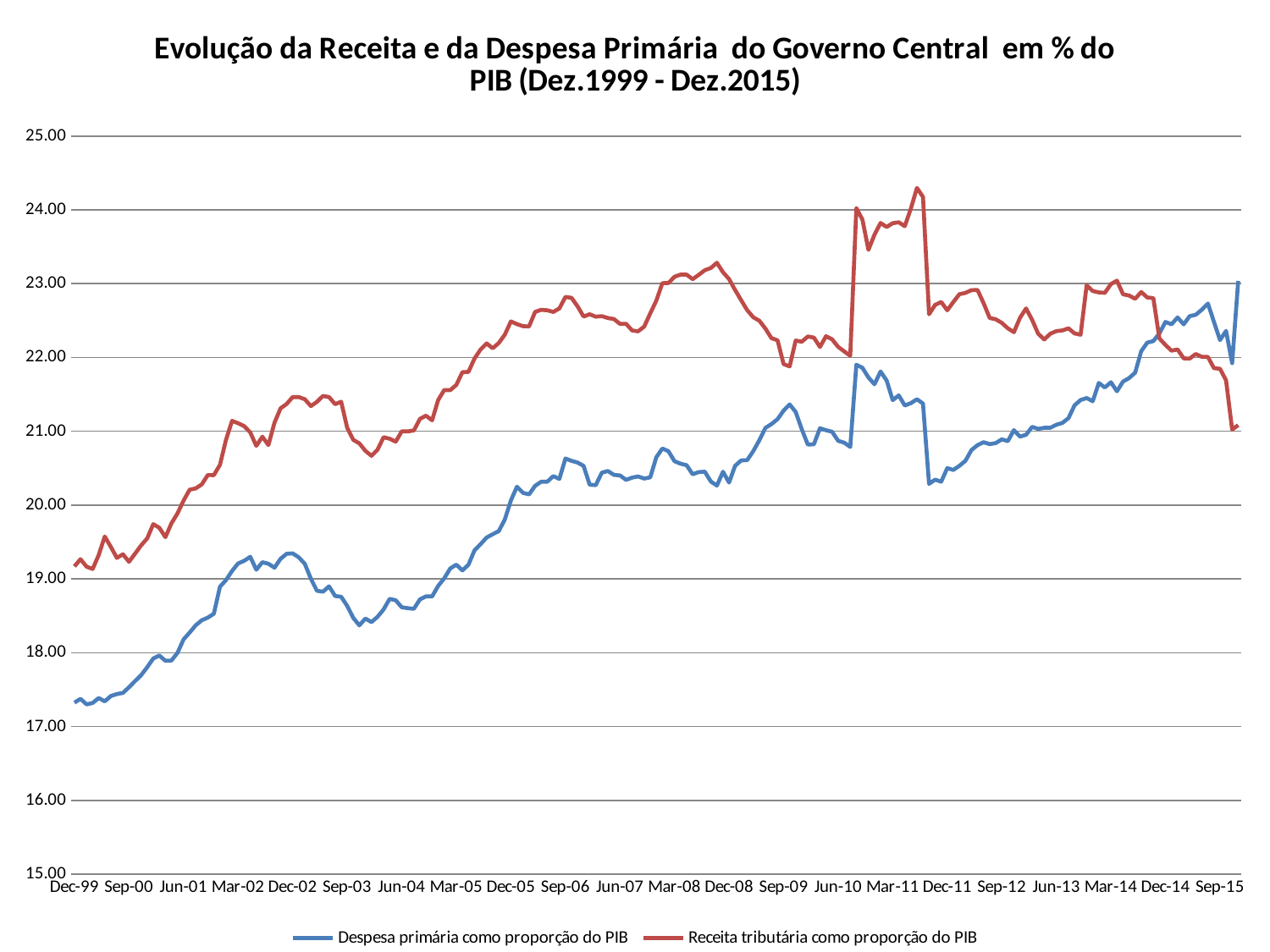
Is the value of Receita tributária como proporção do PIB at Dec-99 greater or less than 19.00? greater Is the value of Despesa primária como proporção do PIB at Dec-99 greater or less than 18.00? less What kind of chart is shown on the slide? line chart At the final point of the series, which line is higher, the blue Despesa primária line or the red Receita tributária line? Despesa primária como proporção do PIB At Dec-99, which series has the higher value, Despesa primária or Receita tributária? Receita tributária como proporção do PIB Is the value of Receita tributária como proporção do PIB at Sep-03 greater or less than 22.00? less What is the title of the chart? Evolução da Receita e da Despesa Primária do Governo Central em % do PIB (Dez.1999 - Dez.2015) Does the Despesa primária como proporção do PIB line overall rise or fall from Dec-99 to the end of the series? rise How many series does the legend list? 2 Which series is shown by the red line? Receita tributária como proporção do PIB